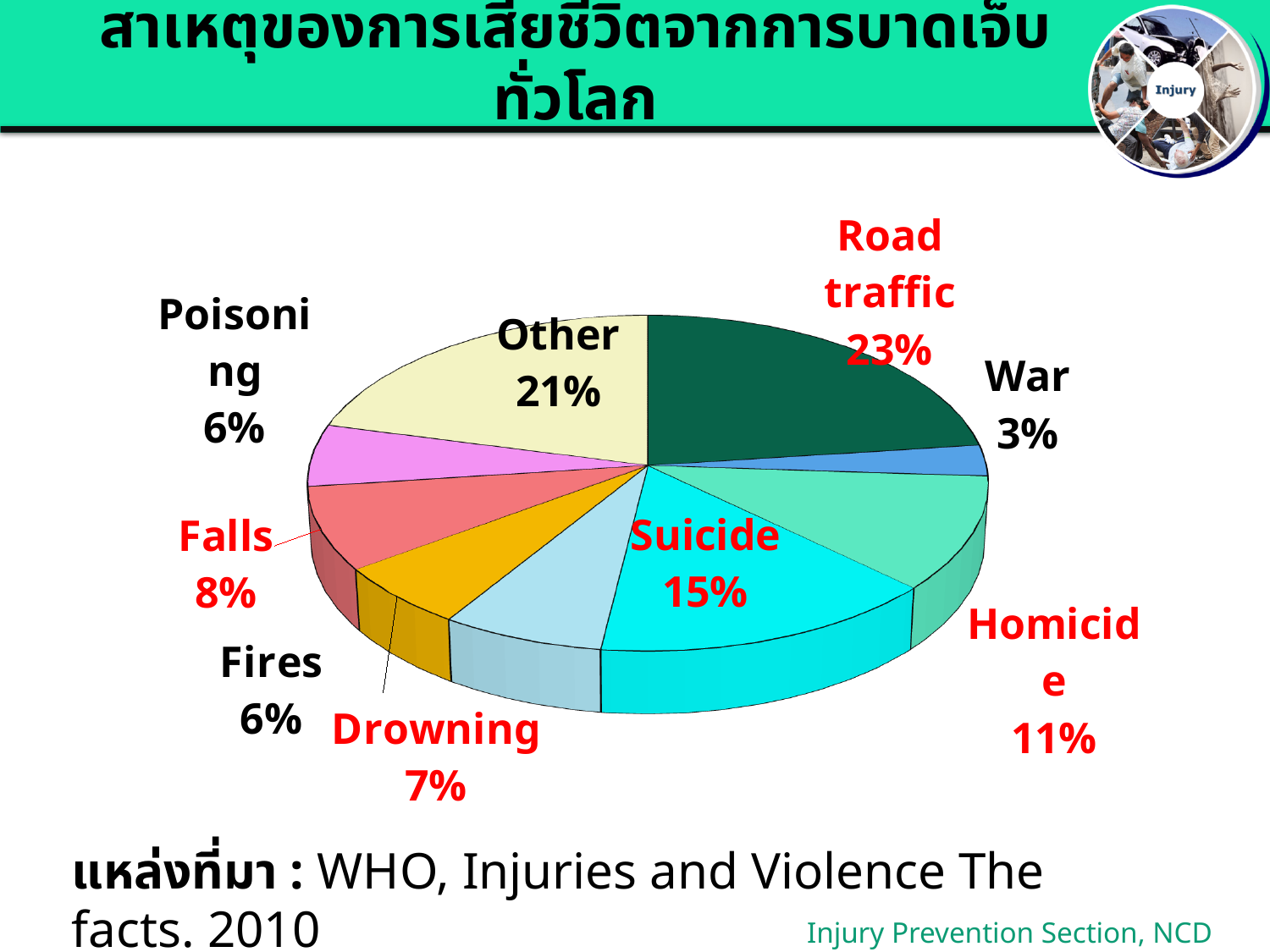
What is the difference in percentage points between Suicide and Homicide? 4 Which category has the smallest share of the pie? War What share of the pie is Homicide? 11% Which two categories both have a share of 6%? Poisoning and Fires Which is larger, the share for Falls or the share for Fires? Falls What share of the pie is Suicide? 15% What kind of chart is shown on the slide? pie chart What is the difference in percentage points between Road traffic and Other? 2 What share of the pie is Drowning? 7% Which category has the largest share of the pie? Road traffic What share of the pie is Road traffic? 23% How many categories are shown in the pie chart? 9